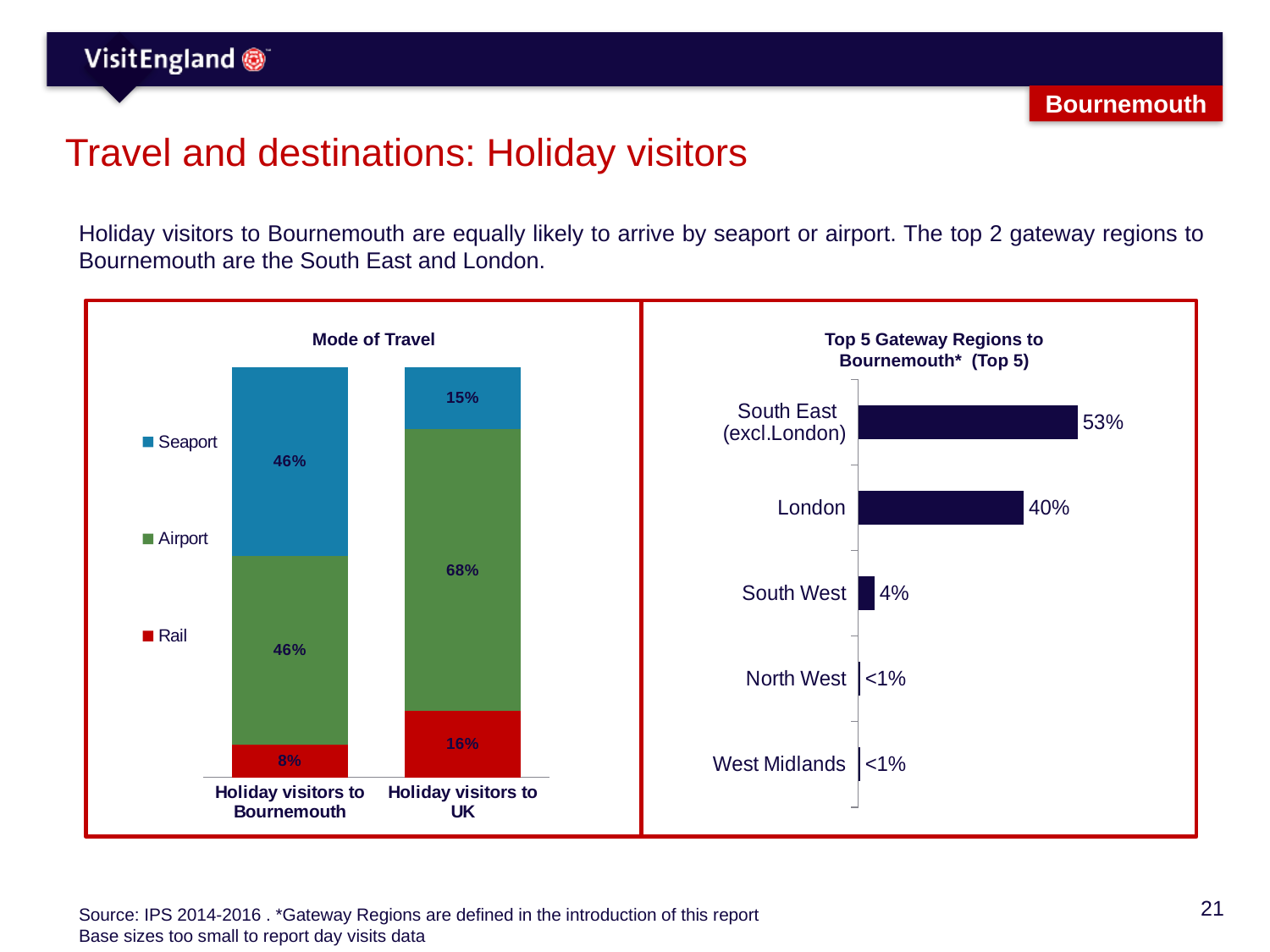
In the Mode of Travel chart, what is the difference between the rail share for holiday visitors to the UK and for holiday visitors to Bournemouth? 8% In the Mode of Travel chart, which colour represents Airport? Green In the Top 5 Gateway Regions to Bournemouth chart, how many regions are shown? 5 In the Top 5 Gateway Regions to Bournemouth chart, what is the difference between South East (excl.London) and London? 13% In the Mode of Travel chart, which is larger: the seaport share for holiday visitors to Bournemouth or for holiday visitors to the UK? Holiday visitors to Bournemouth In the Top 5 Gateway Regions to Bournemouth chart, what is the value for London? 40% In the Mode of Travel chart, what percentage of holiday visitors to Bournemouth arrive by seaport? 46% In the Top 5 Gateway Regions to Bournemouth chart, which region has the highest value? South East (excl.London) What kind of chart is the Top 5 Gateway Regions to Bournemouth chart? Bar chart In the Mode of Travel chart, what percentage of holiday visitors to the UK arrive by airport? 68% In the Mode of Travel chart, how many series does the legend list? 3 In the Mode of Travel chart, what percentage of holiday visitors to Bournemouth arrive by rail? 8%